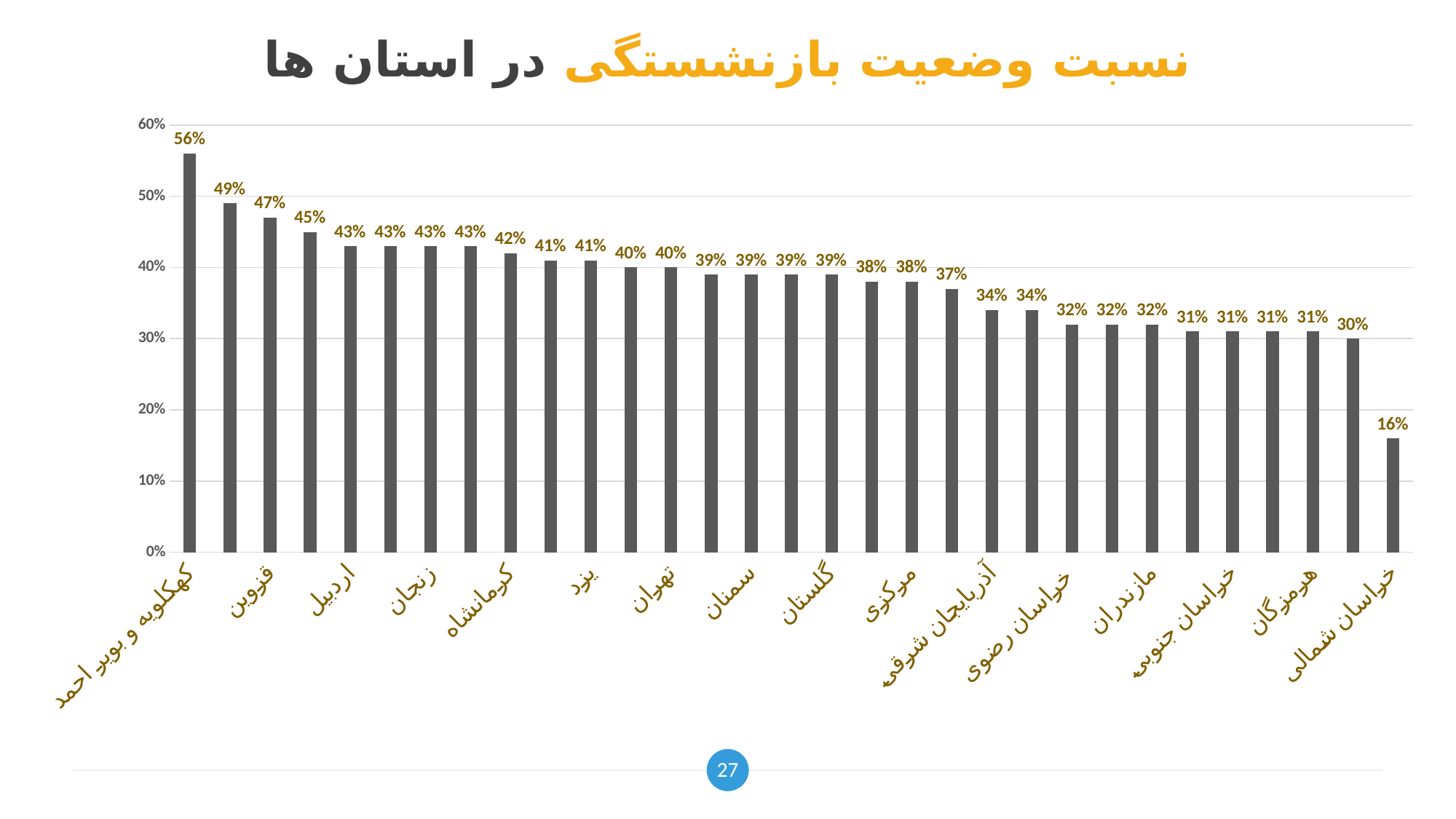
Which is larger, the value for کهکلویه و بویر احمد or the value for خراسان شمالی? کهکلویه و بویر احمد What is the value for قزوین? 47% What kind of chart is shown on the slide? bar chart How many bars are plotted in the chart? 31 What is the value for کهکلویه و بویر احمد? 56% What is the value for خراسان شمالی? 16% What is the value for کرمانشاه? 42% Which province has the lowest value in the chart? خراسان شمالی Which province has the highest value in the chart? کهکلویه و بویر احمد Is the value for خراسان شمالی greater or less than 20%? less What is the difference between the highest value (56%) and the lowest value (16%)? 40% Do the values rise or fall from left to right along the x axis? fall